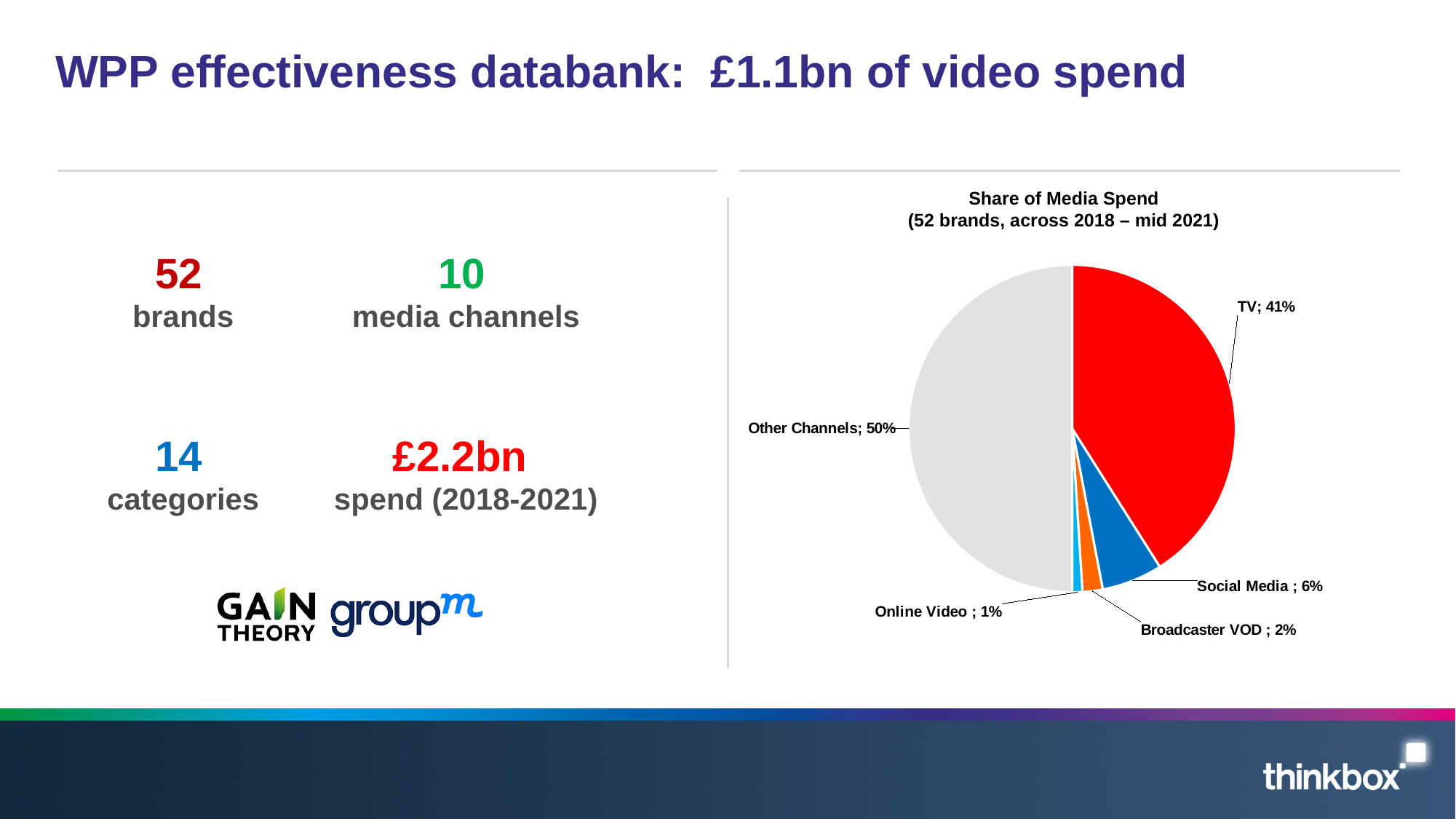
What share of media spend do Other Channels account for? 50% Which has a larger share of media spend, Social Media or Broadcaster VOD? Social Media How many slices does the pie chart have? 5 Which slice of the pie is the smallest? Online Video Which slice of the pie is the largest? Other Channels What kind of chart is shown on the slide? Pie chart What is the difference in share between TV and Social Media? 35% What share of media spend does Online Video account for? 1% What share of media spend does Broadcaster VOD account for? 2% What share of media spend does Social Media account for? 6% What share of media spend does TV account for? 41% What is the title of the chart? Share of Media Spend (52 brands, across 2018 – mid 2021)